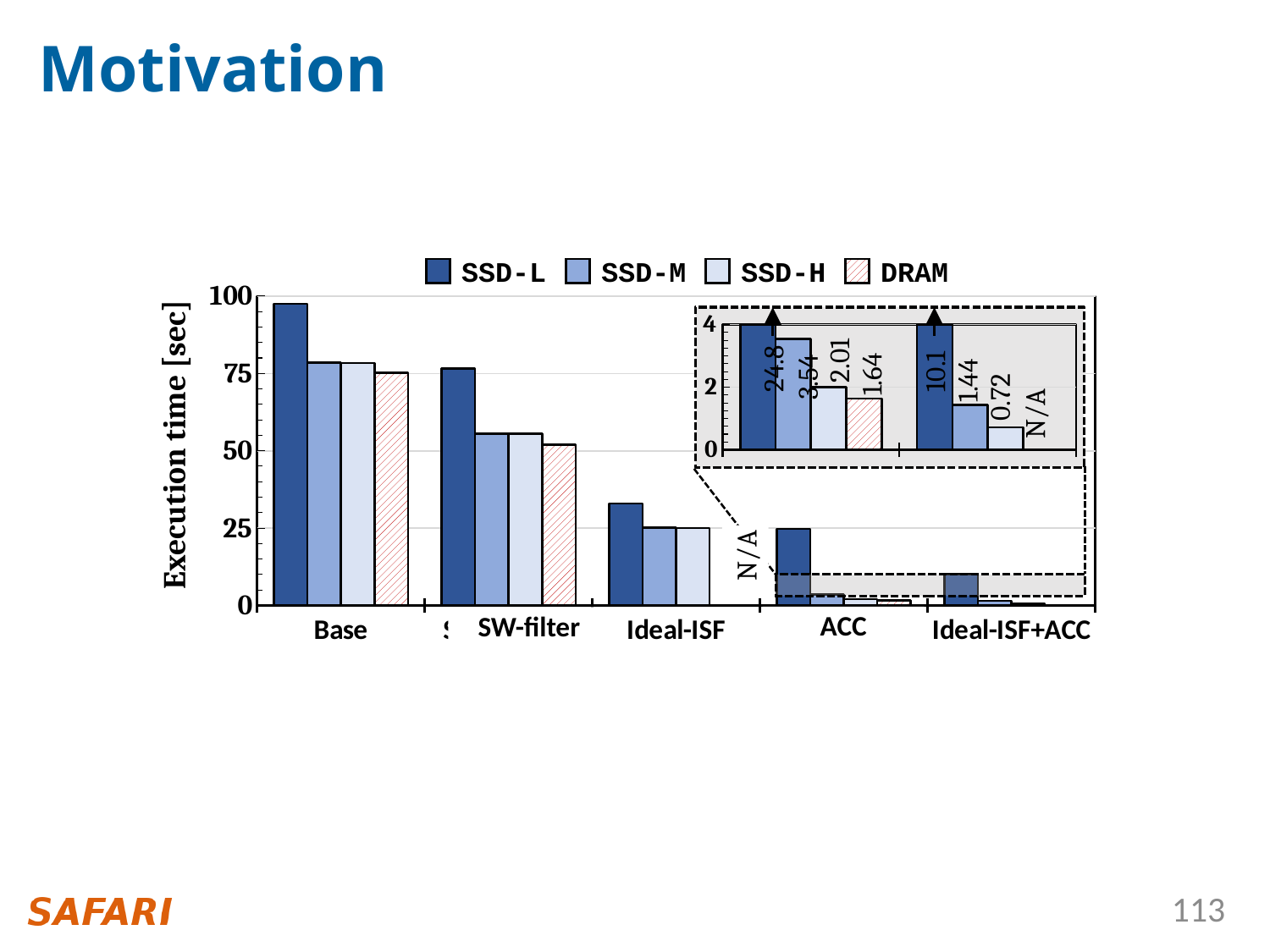
What is the execution time for DRAM in the ACC category? 1.64 What kind of chart is shown on the slide? bar chart What is the execution time for SSD-M in the ACC category? 3.54 How many categories are shown along the x axis? 5 What is the difference between the SSD-L and SSD-M execution times in the ACC category? 21.26 What is the label of the y axis? Execution time [sec] What is the execution time for SSD-L in the Ideal-ISF+ACC category? 10.1 What is shown for DRAM in the Ideal-ISF+ACC category? N/A Which category has the highest SSD-L execution time? Base How many series does the legend list? 4 What is the execution time for SSD-L in the ACC category? 24.8 Is the SSD-L execution time for Base greater or less than 75? greater